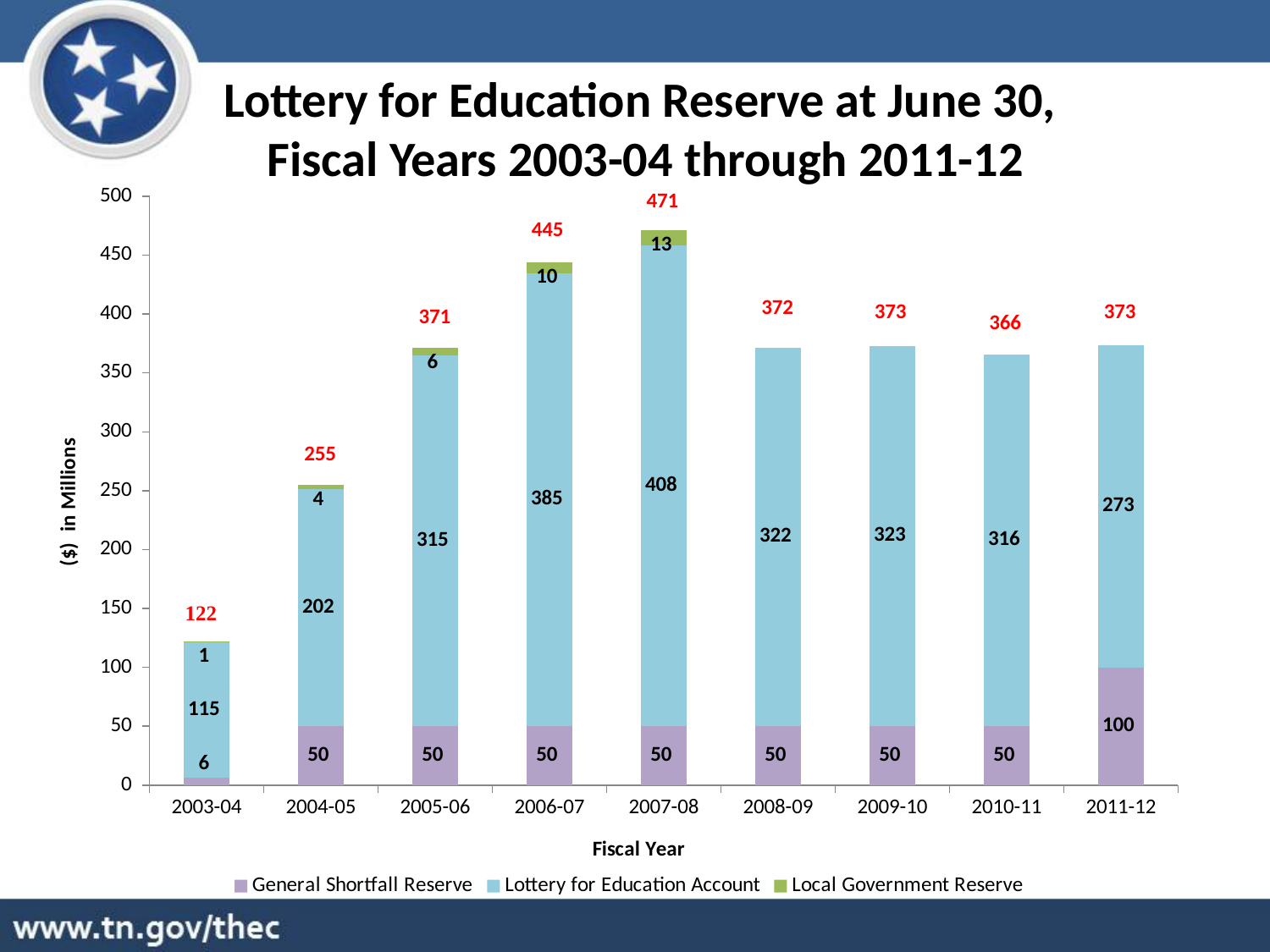
What is the total reserve shown for fiscal year 2006-07? 445 How many series does the legend list? 3 Which fiscal year has the highest total Lottery for Education Reserve? 2007-08 What is the difference between the Lottery for Education Account values in 2007-08 and 2006-07? 23 Which is larger, the Lottery for Education Account in 2005-06 or in 2011-12? 2005-06 Which fiscal year has the lowest total Lottery for Education Reserve? 2003-04 How many fiscal years are shown on the x axis? 9 What is the Local Government Reserve value for fiscal year 2006-07? 10 What is the General Shortfall Reserve value for fiscal year 2011-12? 100 Do the total reserve values rise or fall from fiscal year 2003-04 to 2007-08? Rise What kind of chart is shown on the slide? Stacked bar chart What is the value of the Lottery for Education Account in fiscal year 2007-08? 408